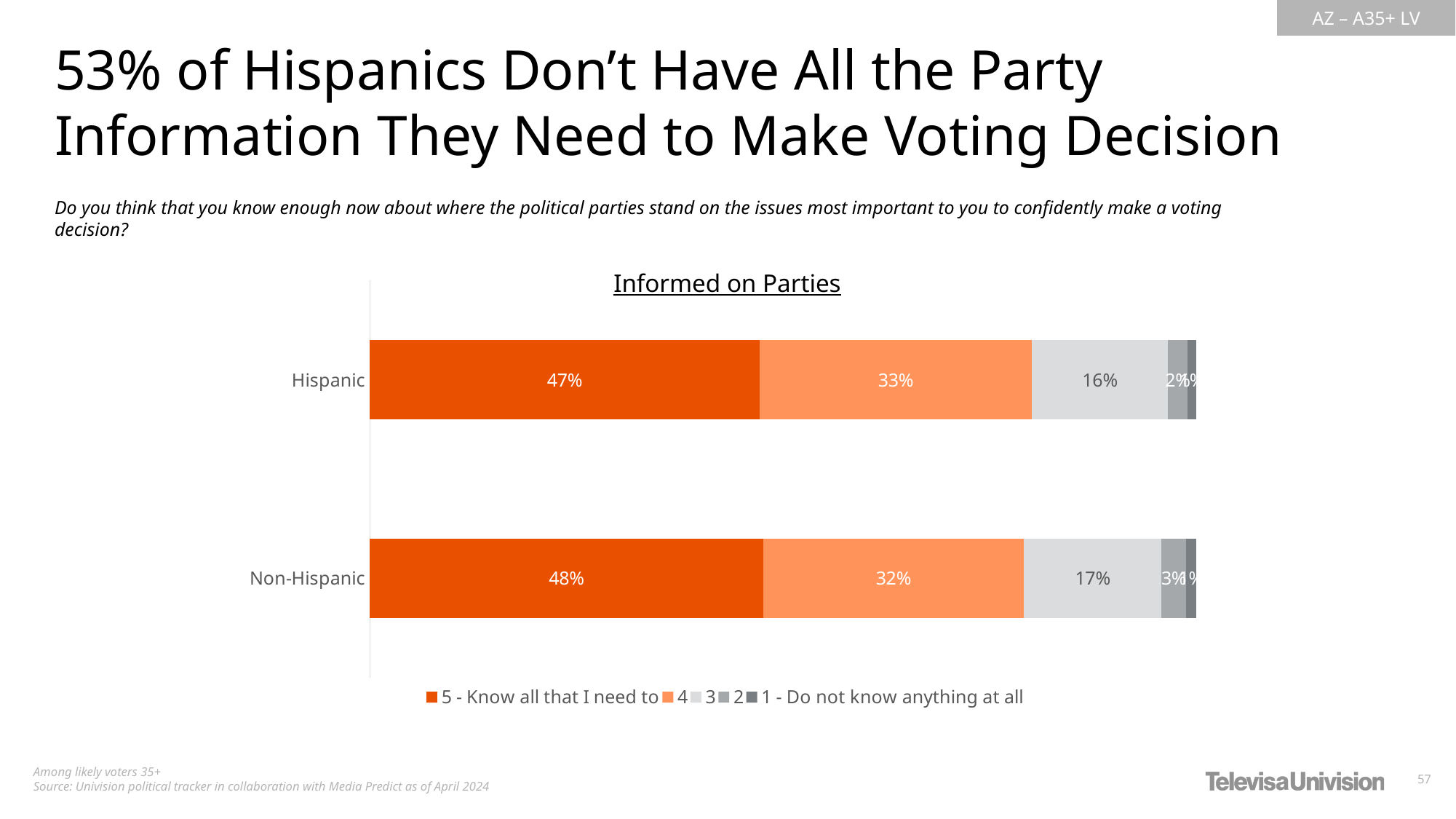
What percentage of Non-Hispanic respondents answered "5 - Know all that I need to"? 48% Which group has the larger "5 - Know all that I need to" share, Hispanic or Non-Hispanic? Non-Hispanic What is the value of the "4" segment for Non-Hispanic respondents? 32% For Hispanic respondents, what is the difference between the "5 - Know all that I need to" segment and the "4" segment? 14 percentage points What percentage of Hispanic respondents answered "5 - Know all that I need to"? 47% Which response category is the largest segment of the Hispanic bar? 5 - Know all that I need to What is the value of the "4" segment for Hispanic respondents? 33% What is the value of the "3" segment for Non-Hispanic respondents? 17% How many groups (bars) are shown in the chart? 2 What is the value of the "3" segment for Hispanic respondents? 16% How many series does the legend list? 5 What type of chart is shown on the slide? Stacked bar chart